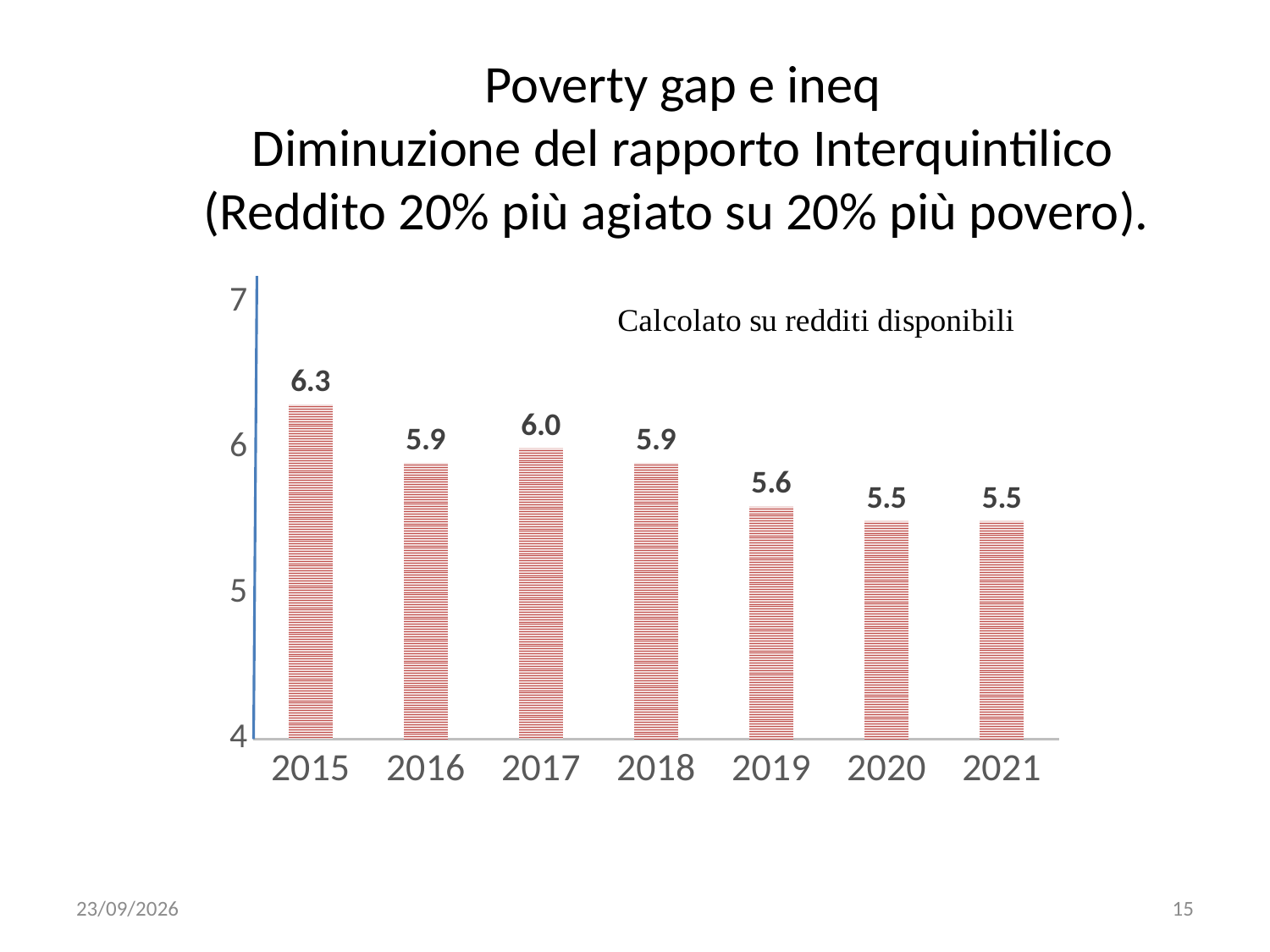
What is the value for 2015? 6.3 What kind of chart is shown on the slide? bar chart Is the value for 2020 greater or less than 6? less How many years are shown on the x axis? 7 What is the difference between the values for 2015 and 2021? 0.8 Do the values generally rise or fall from 2015 to 2021? fall Is the value for 2015 greater or less than 6? greater Which is larger, the value for 2016 or the value for 2017? 2017 What is the difference between the values for 2017 and 2019? 0.4 What is the value for 2019? 5.6 Which year has the highest value? 2015 What is the value for 2017? 6.0